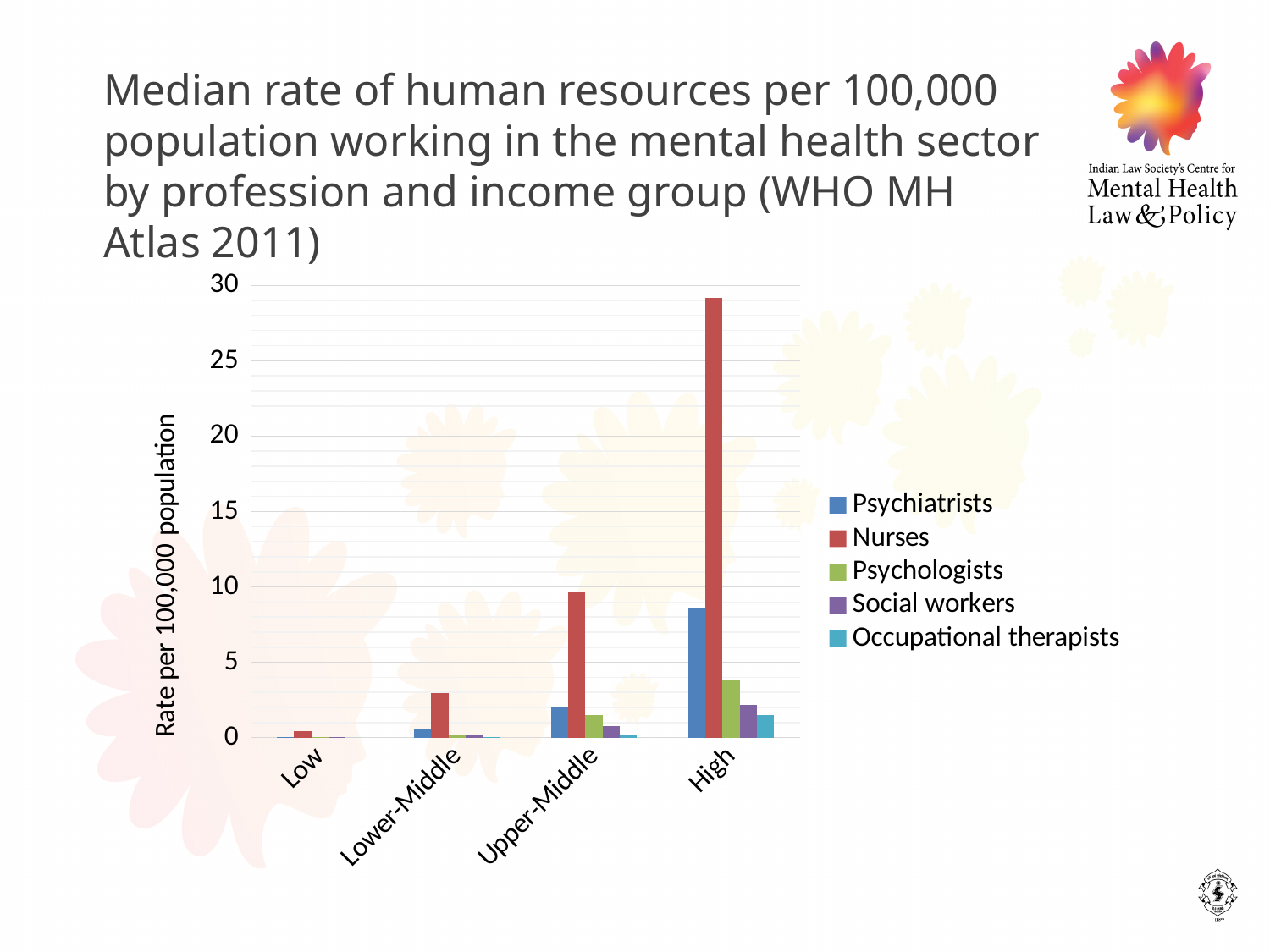
How many income groups are shown on the x axis? 4 How many series does the legend list? 5 In the High income group, which is larger: Nurses or Psychiatrists? Nurses What kind of chart is shown on the slide? bar chart Is the value for Nurses in the High income group greater or less than 25? greater Is the value for Nurses in the Lower-Middle income group greater or less than 5? less Do the values for Nurses rise or fall as the income group moves from Low to High? rise Is the value for Nurses in the Upper-Middle income group greater or less than 15? less What is the label on the y axis? Rate per 100,000 population Which income group has the lowest value for Nurses? Low Which income group has the highest value for Nurses? High